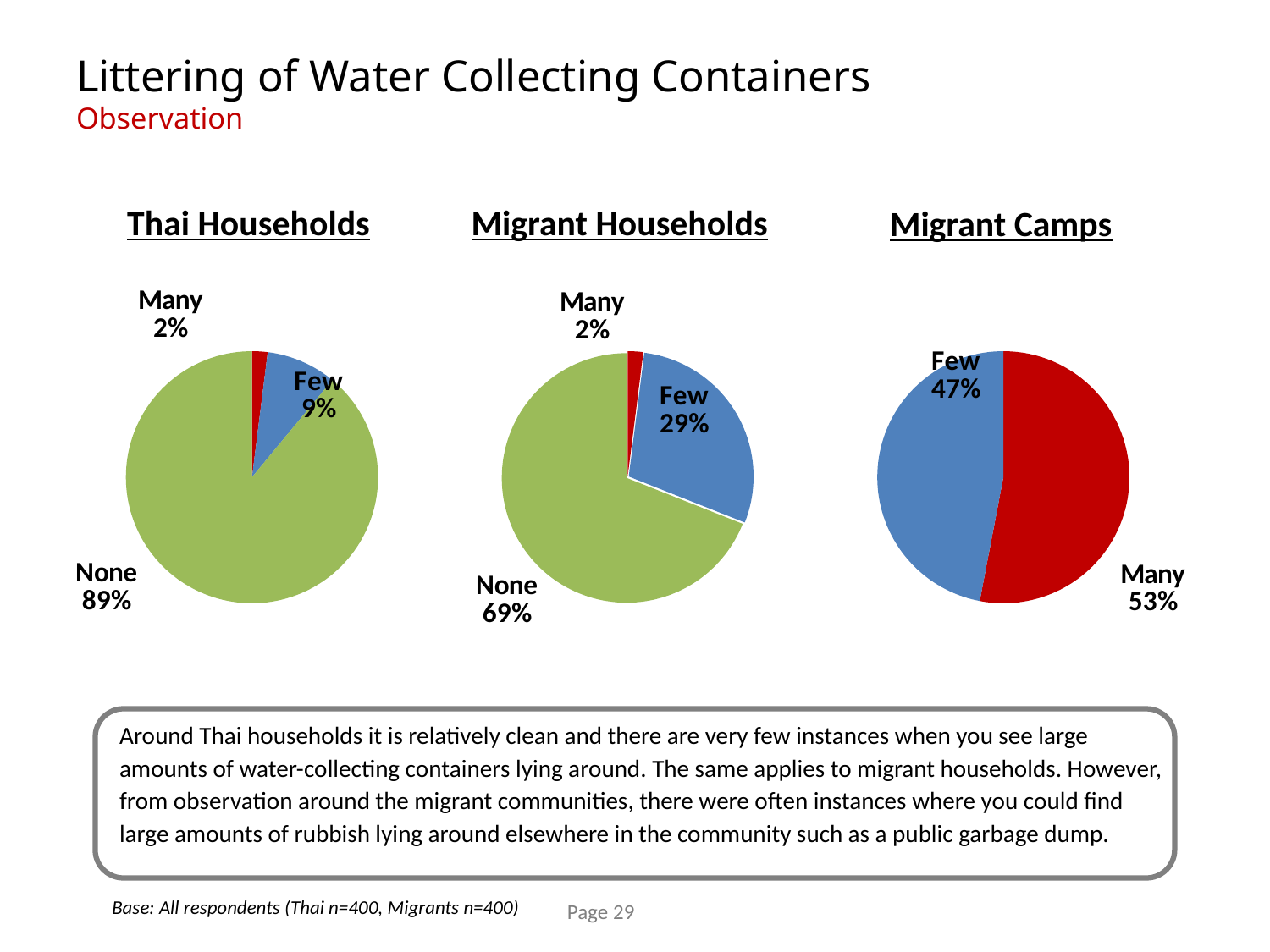
In the Thai Households chart, which category has the largest slice? None In the Migrant Camps chart, which category has the larger slice? Many Which is larger: the Few share in the Migrant Households chart or the Few share in the Thai Households chart? Migrant Households In the Migrant Camps chart, what share of the pie is labelled Few? 47% In the Migrant Households chart, what share of the pie is labelled Few? 29% In the Migrant Camps chart, what share of the pie is labelled Many? 53% In the Thai Households chart, what share of the pie is labelled None? 89% How many slices does the Thai Households chart have? 3 What type of chart is used for the Migrant Households data? Pie chart In the Migrant Households chart, which category has the smallest slice? Many How many slices does the Migrant Camps chart have? 2 What is the difference between the None share in the Thai Households chart and the None share in the Migrant Households chart? 20%